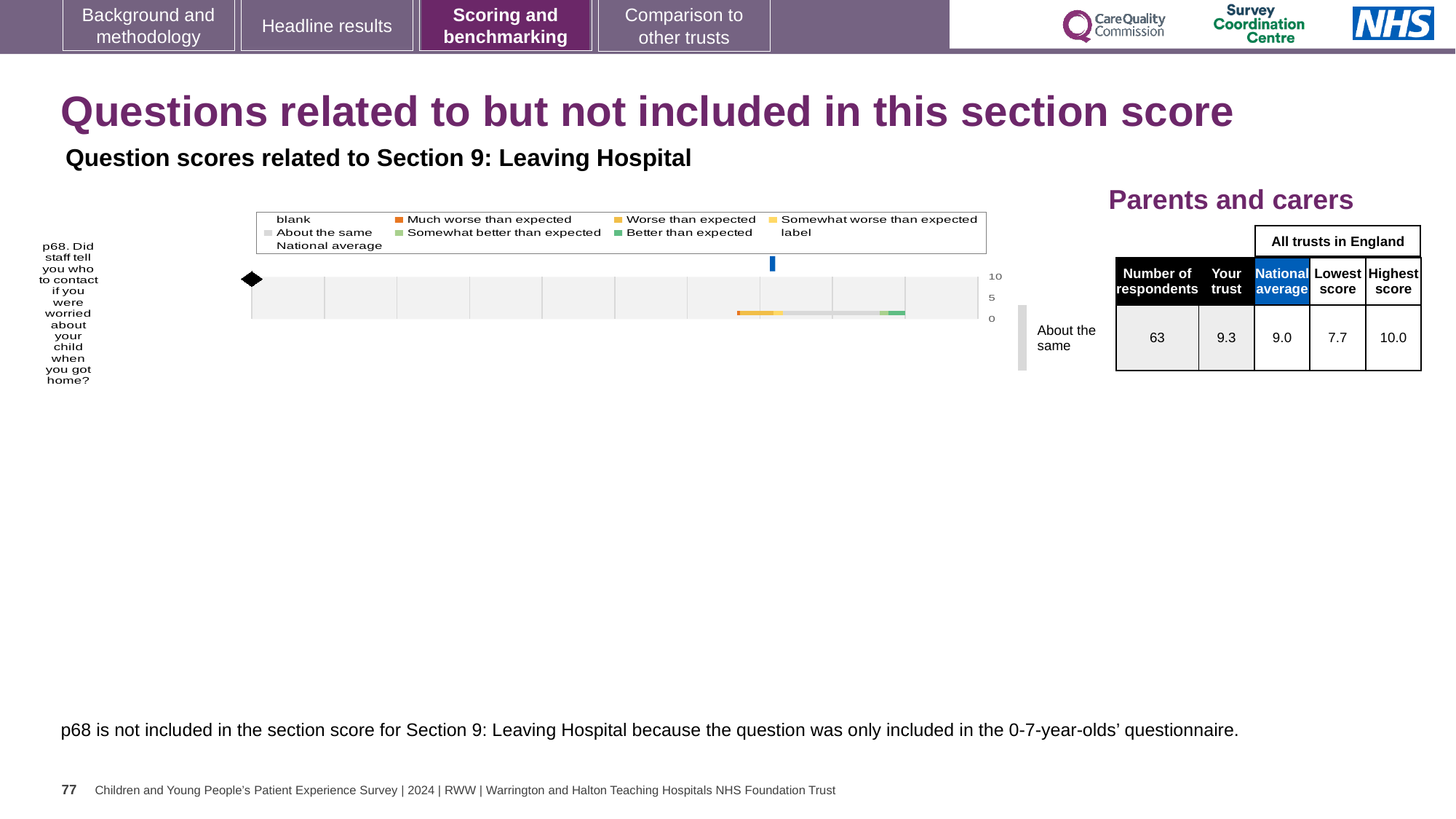
How many entries does the chart legend list? 9 Which is larger for p68, the 'Your trust' score or the national average? Your trust What is the national average score for p68? 9.0 How many questions are plotted in the chart? 1 How many respondents answered question p68? 63 What is the 'Your trust' score for p68? 9.3 What is the lowest score among all trusts in England for p68? 7.7 What kind of chart is shown on the slide for question p68? bar chart What benchmark category is shown for p68 next to the chart? About the same What is the difference between the highest score and the lowest score for p68? 2.3 What is the highest tick value shown on the chart's score axis? 10 What is the highest score among all trusts in England for p68? 10.0